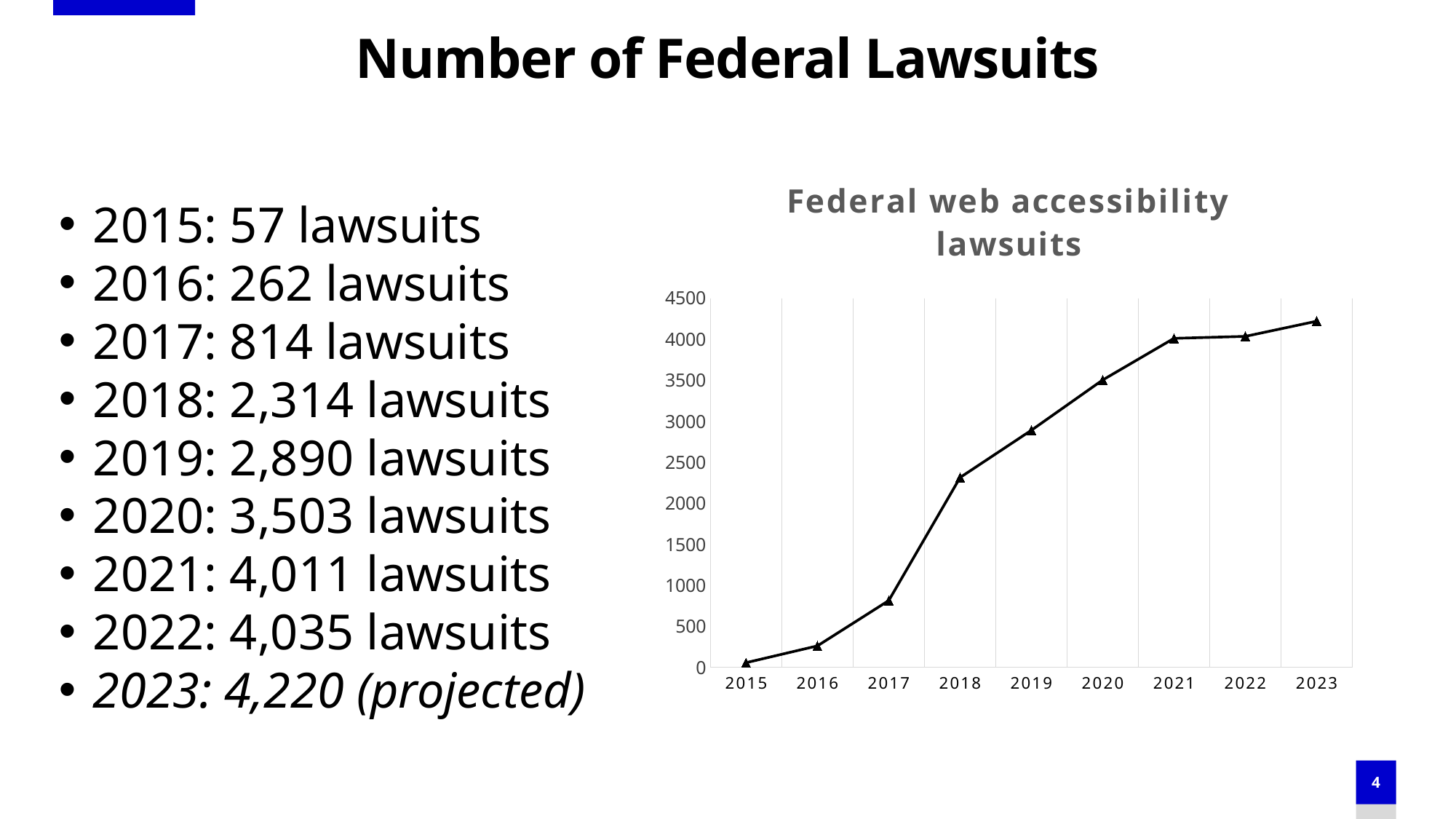
How many years are plotted on the x axis of the chart? 9 Which year has more lawsuits in the chart, 2019 or 2021? 2021 Which year has the highest number of federal web accessibility lawsuits in the chart? 2023 According to the slide, what is the projected number of federal lawsuits for 2023? 4,220 Is the value for 2017 in the chart greater or less than 1000? less What is the title of the chart? Federal web accessibility lawsuits According to the slide, how many federal lawsuits were there in 2018? 2,314 lawsuits Is the value for 2020 in the chart greater or less than 3000? greater Which year has the lowest number of federal web accessibility lawsuits in the chart? 2015 Do the values in the chart rise or fall from 2015 to 2023? rise What kind of chart is shown on the slide? line chart Is the value for 2018 in the chart greater or less than 2000? greater